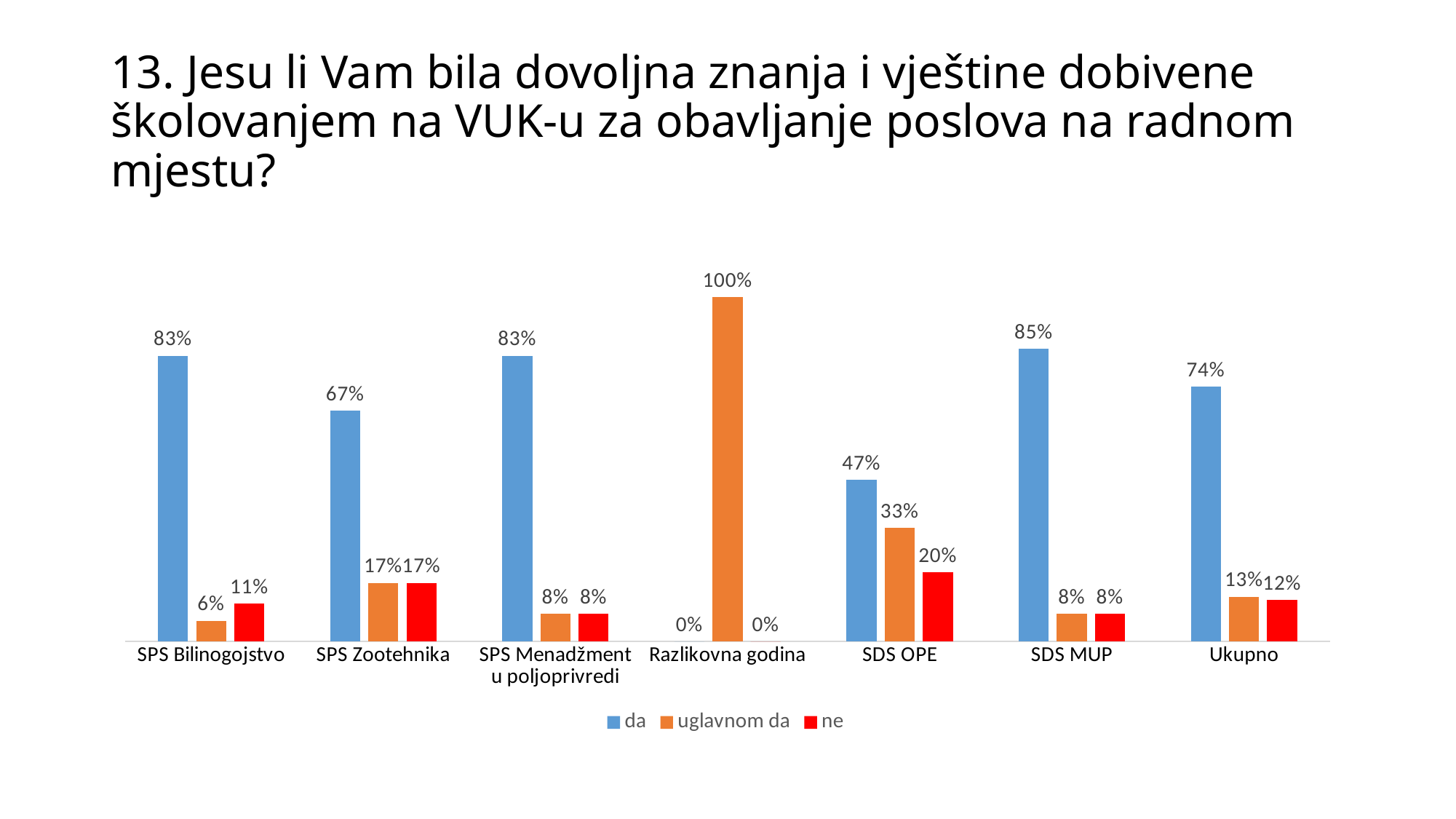
How many series does the legend list? 3 Which colour represents the "ne" series in the legend? red Which is larger: the "ne" value for SDS OPE or the "ne" value for SPS Zootehnika? SDS OPE What is the value for "uglavnom da" for SDS OPE? 33% Which category has the lowest value for "ne"? Razlikovna godina What is the value for "da" for SPS Zootehnika? 67% What kind of chart is shown on the slide? bar chart Which category has the highest value for "da"? SDS MUP What is the difference between the "da" values for SDS MUP and SDS OPE? 38% What is the value for "uglavnom da" for Razlikovna godina? 100% What is the value for "ne" for Ukupno? 12% How many categories are shown on the x axis? 7